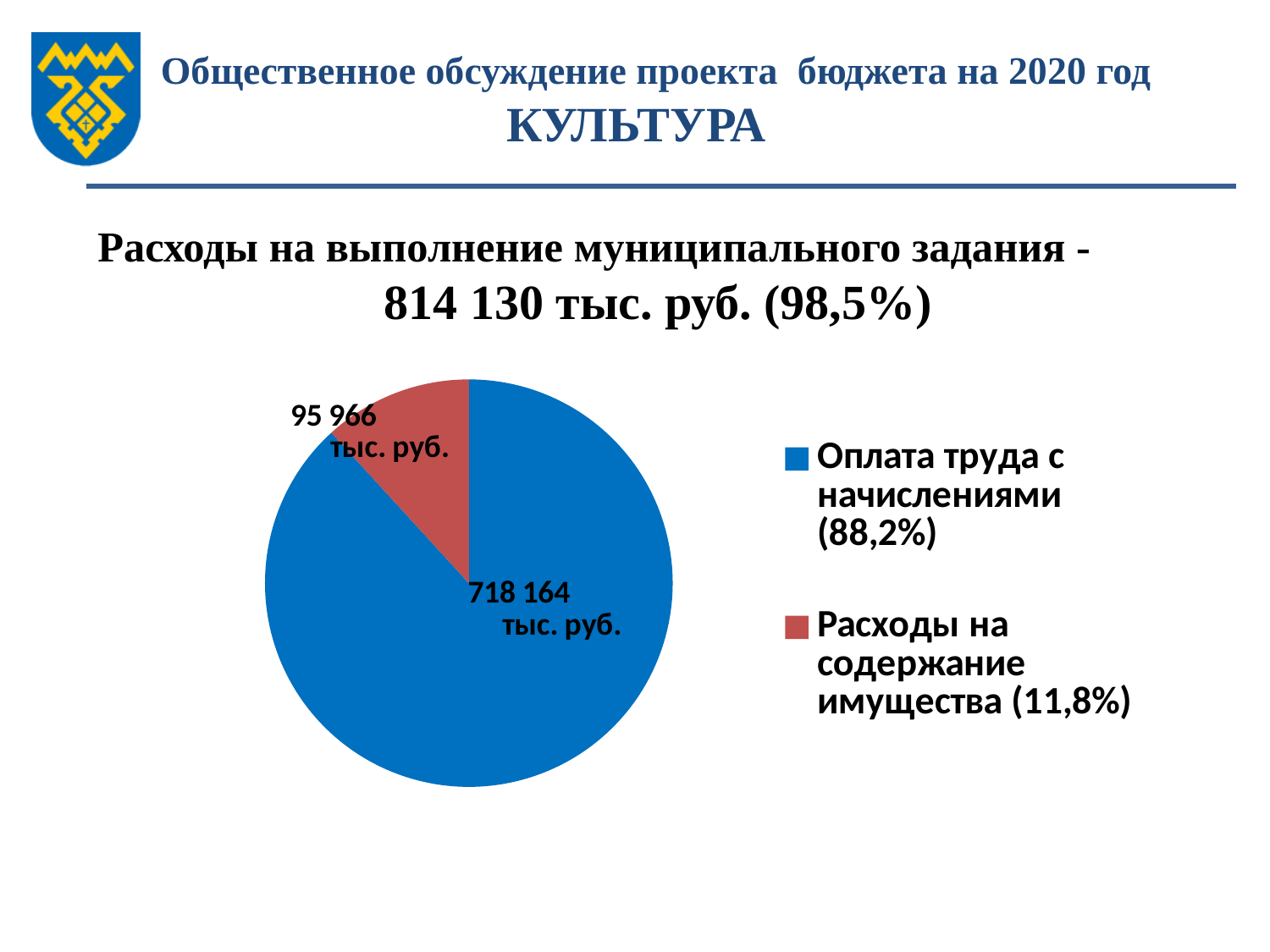
What kind of chart is shown on the slide? pie chart Which is larger: "Оплата труда с начислениями" or "Расходы на содержание имущества"? Оплата труда с начислениями What share of the pie does "Расходы на содержание имущества" represent, according to the legend? 11,8% What total amount for "Расходы на выполнение муниципального задания" is stated above the chart? 814 130 тыс. руб. (98,5%) How many categories does the pie chart have? 2 What is the difference between the values for "Оплата труда с начислениями" and "Расходы на содержание имущества"? 622 198 тыс. руб. What is the value for "Оплата труда с начислениями"? 718 164 тыс. руб. What is the value for "Расходы на содержание имущества"? 95 966 тыс. руб. What colour is the slice for "Расходы на содержание имущества"? red What share of the pie does "Оплата труда с начислениями" represent, according to the legend? 88,2% Which category has the largest slice of the pie? Оплата труда с начислениями Which category has the smallest slice of the pie? Расходы на содержание имущества